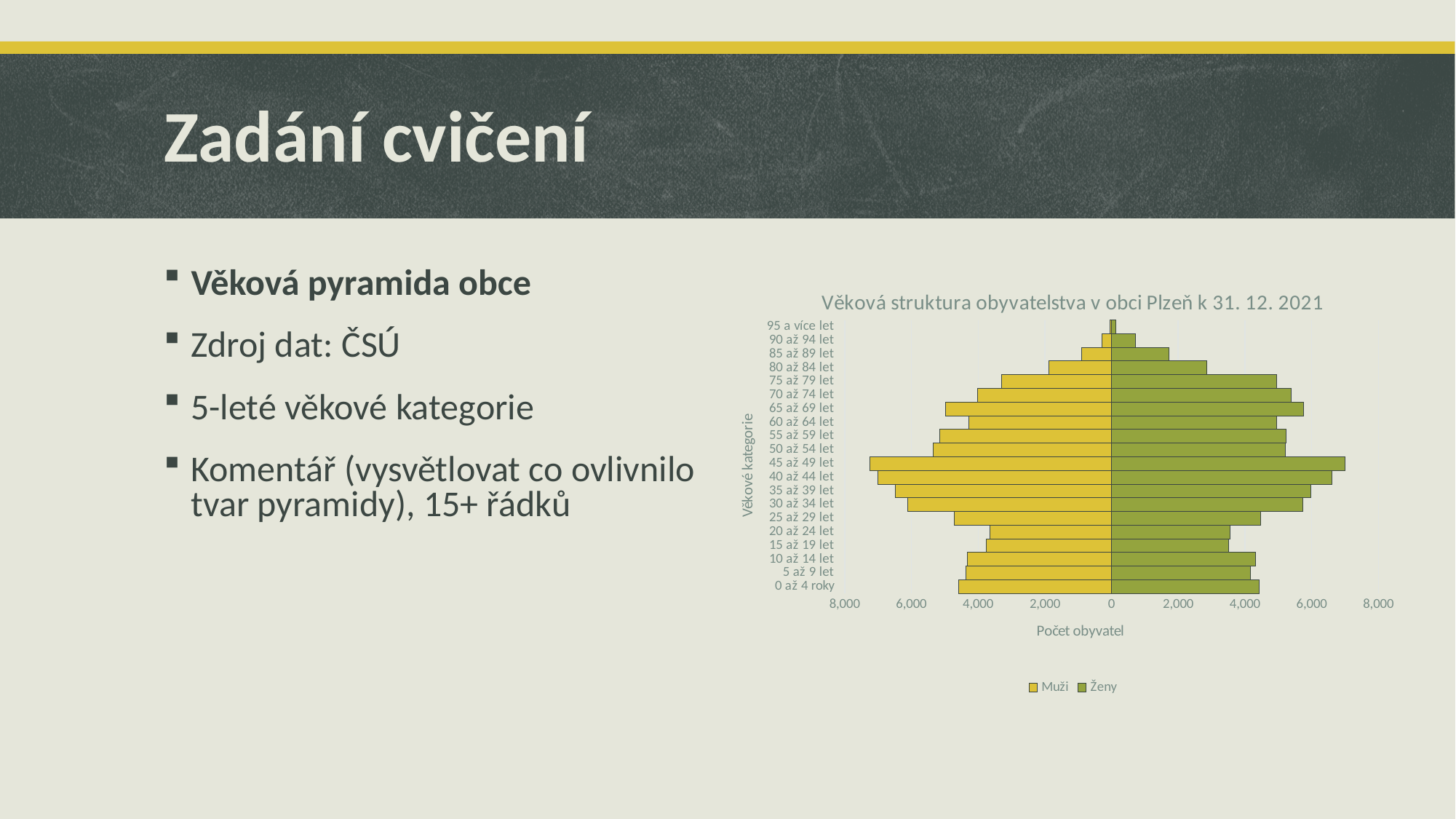
How many series does the chart legend list? 2 What kind of chart is shown on the slide? bar chart Which is larger for Ženy: the value for 65 až 69 let or the value for 20 až 24 let? 65 až 69 let Is the value for Ženy in the 85 až 89 let category greater or less than 2,000? less Is the value for Ženy in the 65 až 69 let category greater or less than 4,000? greater Which age category has the lowest value for Ženy? 95 a více let How many age categories are plotted on the chart? 20 What is the title of the chart? Věková struktura obyvatelstva v obci Plzeň k 31. 12. 2021 What is the label of the horizontal axis of the chart? Počet obyvatel Is the value for Muži in the 45 až 49 let category greater or less than 6,000? greater Which age category has the highest value for Muži? 45 až 49 let